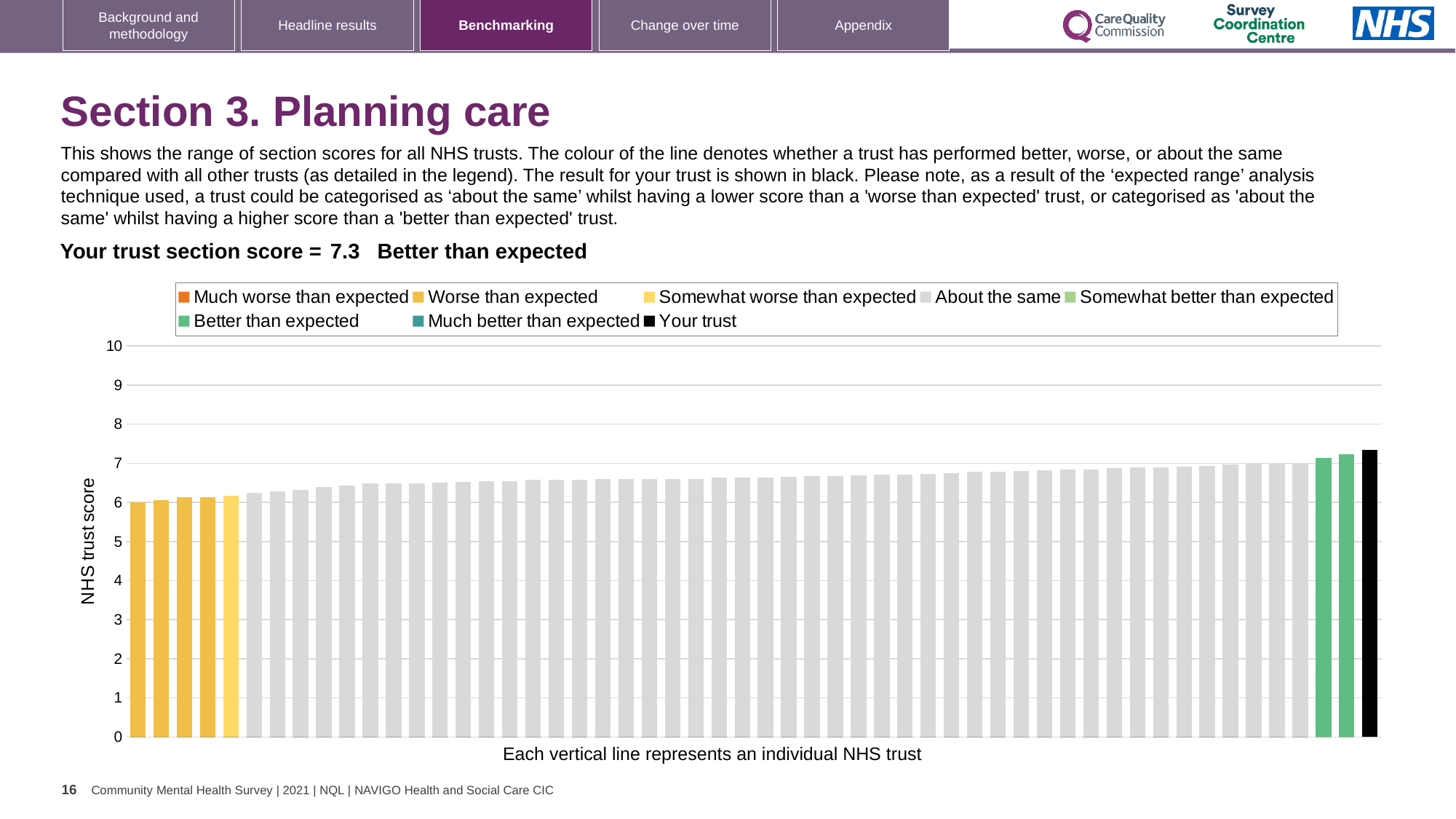
How many bars are coloured as 'Worse than expected'? 4 Do the bar values rise or fall from left to right along the x axis? rise Is the value for your trust greater or less than 7? greater Is the value of the lowest bar greater or less than 7? less Which is larger: the value for your trust or the value of the leftmost bar? your trust What is the label on the y axis of the chart? NHS trust score How many bars are coloured as 'Better than expected' (green)? 2 How is your trust's section score categorised on the slide? Better than expected What is the section score for your trust shown on the slide? 7.3 Is the value of the lowest bar greater or less than 5? greater What kind of chart is shown on the slide? bar chart How many entries does the chart legend list? 8